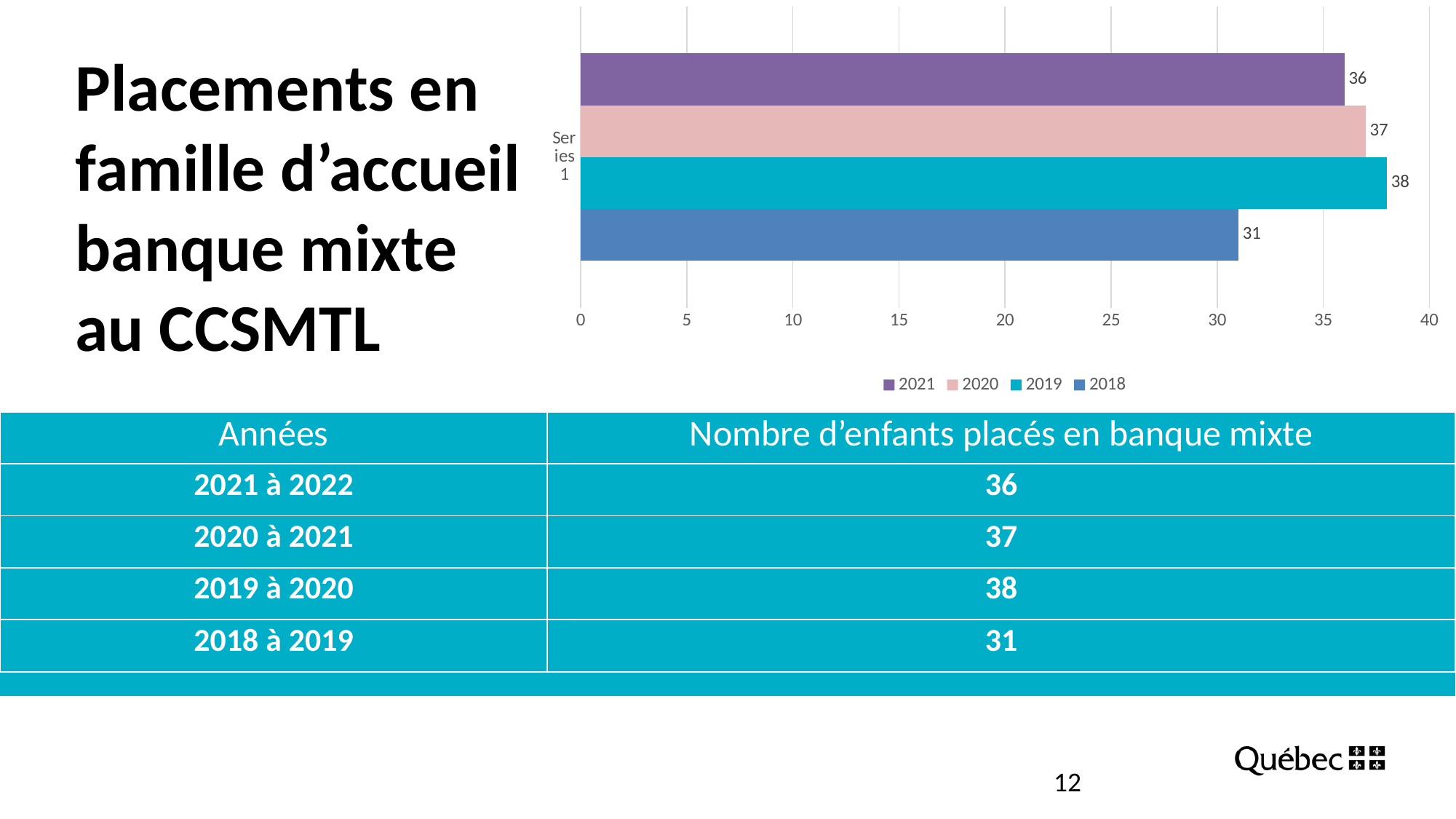
What colour is the 2019 bar in the chart? teal Which is larger in the chart, the 2020 value or the 2021 value? 2020 What is the value of the 2021 bar in the chart? 36 What is the value of the 2019 bar in the chart? 38 What is the value of the 2020 bar in the chart? 37 How many series does the chart legend list? 4 Which series has the highest value in the chart? 2019 Which series has the lowest value in the chart? 2018 Is the value for 2018 in the chart greater or less than 35? less What kind of chart is shown on the slide? bar chart What is the value of the 2018 bar in the chart? 31 What is the difference between the 2019 value and the 2018 value in the chart? 7